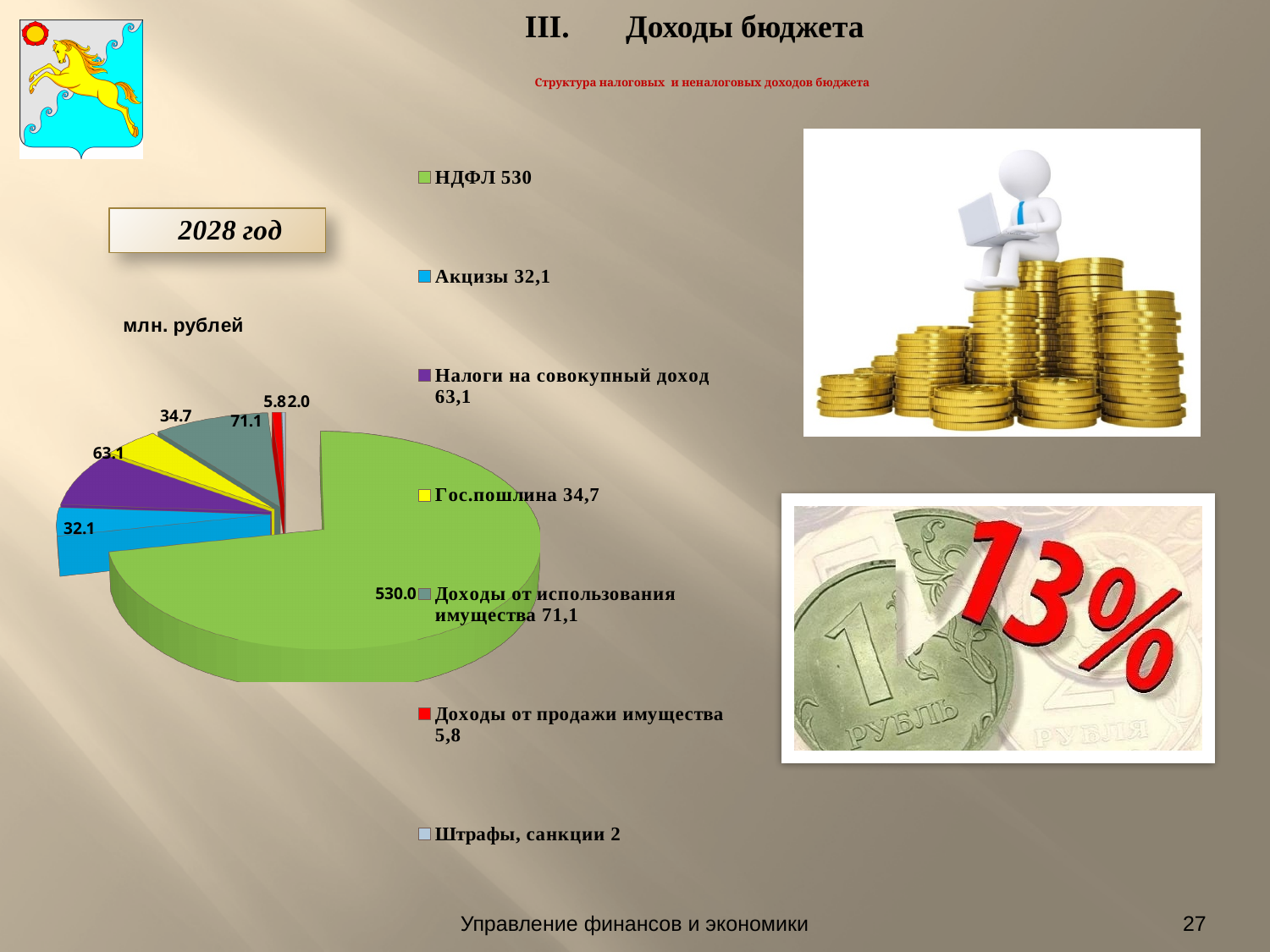
Which category has the largest slice in the pie chart? НДФЛ Which category has the smallest slice in the pie chart? Штрафы, санкции What is the difference between the values for Доходы от использования имущества and Налоги на совокупный доход? 8.0 What kind of chart is shown on the slide? pie chart Which year does the pie chart refer to, according to the label next to it? 2028 год How many slices does the pie chart have? 7 What unit is stated for the values in the pie chart? млн. рублей What is the value of the Гос.пошлина slice in the pie chart? 34.7 What is the value of the Акцизы slice in the pie chart? 32.1 Which is larger: the value for Акцизы or the value for Гос.пошлина? Гос.пошлина What is the value of the НДФЛ slice in the pie chart? 530.0 What is the difference between the values for Доходы от продажи имущества and Штрафы, санкции? 3.8